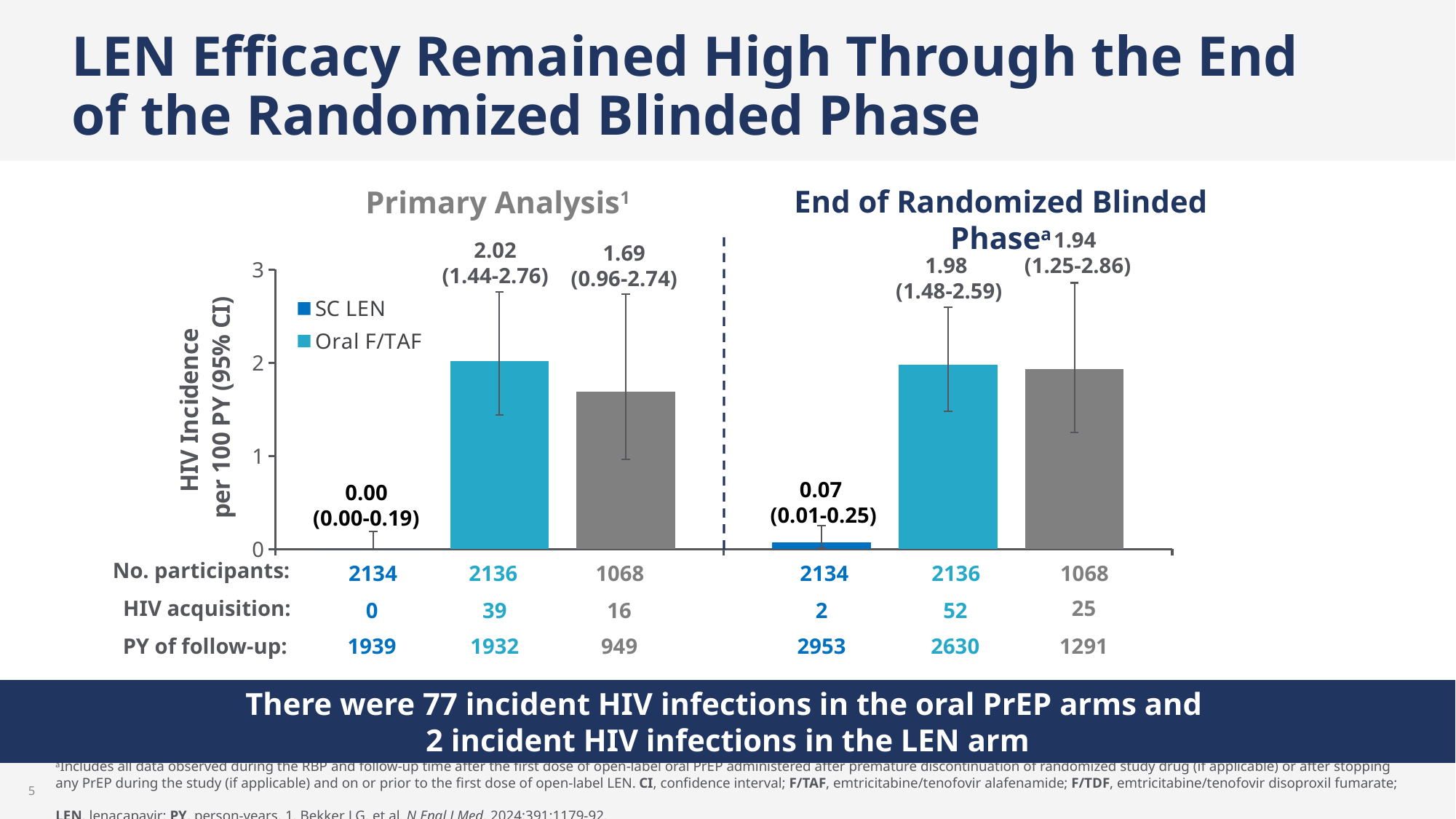
What is the HIV incidence per 100 PY for SC LEN in the Primary Analysis? 0.00 Is the HIV incidence for Oral F/TAF at the End of Randomized Blinded Phase greater or less than 1? greater Which is larger: the HIV incidence for Oral F/TAF in the Primary Analysis or for SC LEN in the Primary Analysis? Oral F/TAF in the Primary Analysis What is the HIV incidence per 100 PY for Oral F/TAF at the End of Randomized Blinded Phase? 1.98 What is the difference in HIV incidence per 100 PY between Oral F/TAF and SC LEN in the Primary Analysis? 2.02 How many series does the chart legend list? 2 What is the 95% CI shown for SC LEN at the End of Randomized Blinded Phase? 0.01-0.25 What is the 95% CI shown for Oral F/TAF in the Primary Analysis? 1.44-2.76 What type of chart is shown on the slide? Bar chart What is the HIV incidence per 100 PY for Oral F/TAF in the Primary Analysis? 2.02 What is the HIV incidence per 100 PY for SC LEN at the End of Randomized Blinded Phase? 0.07 Which group has the highest HIV incidence in the Primary Analysis? Oral F/TAF